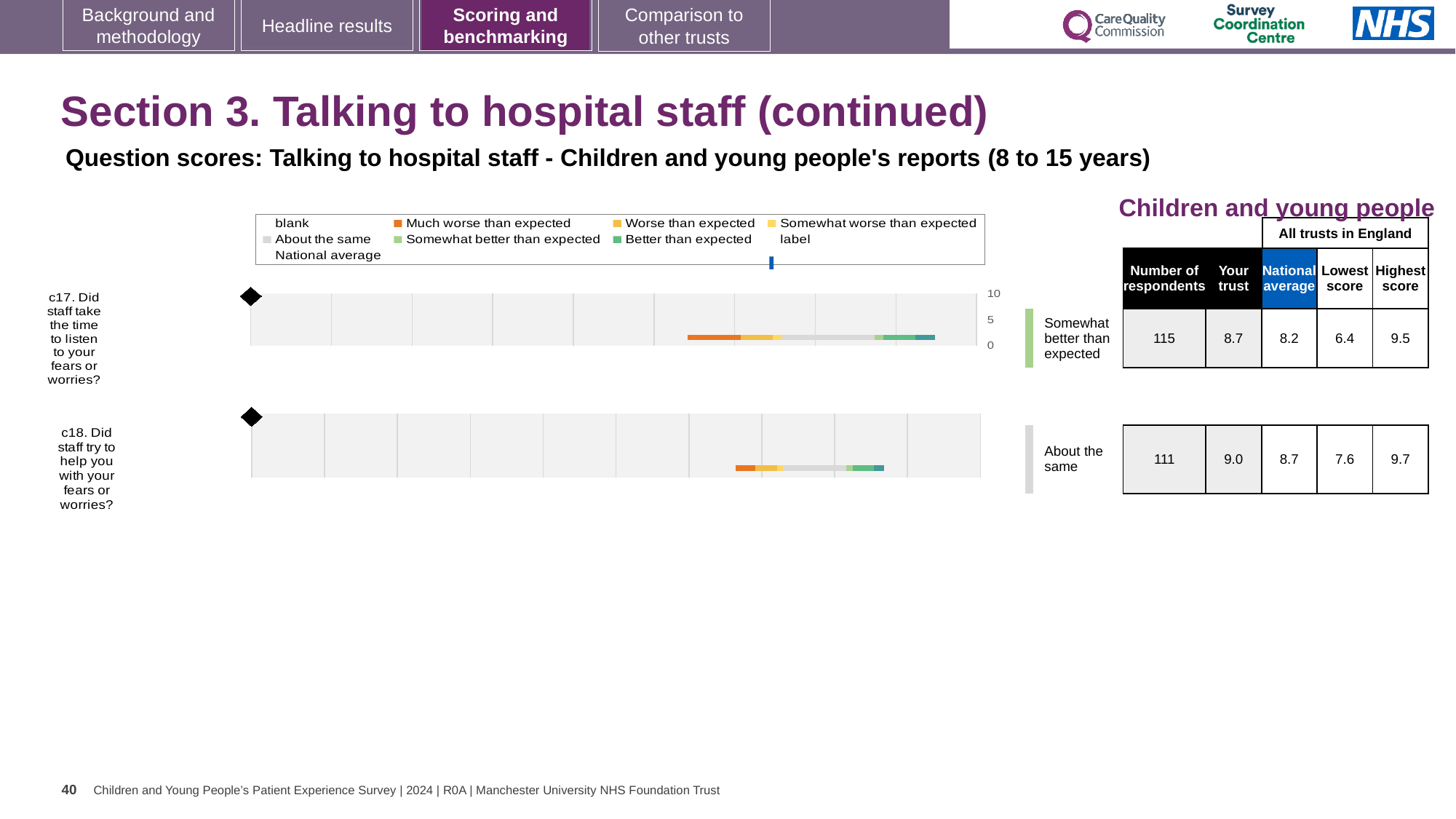
How many respondents answered c18? 111 What is the national average score for c17? 8.2 What kind of chart is used to show the question scores for c17 and c18? bar chart What is the highest score across all trusts in England for c18? 9.7 What is the 'Your trust' score for c18 (Did staff try to help you with your fears or worries?)? 9.0 Which question has the higher 'Your trust' score, c17 or c18? c18 Which benchmark category is shown for c18? About the same What is the 'Your trust' score for c17 (Did staff take the time to listen to your fears or worries?)? 8.7 Which benchmark category is shown for c17? Somewhat better than expected Which legend entry is shown in orange? Much worse than expected How many survey questions are plotted on the chart? 2 By how much does the trust's score for c17 exceed the national average for c17? 0.5